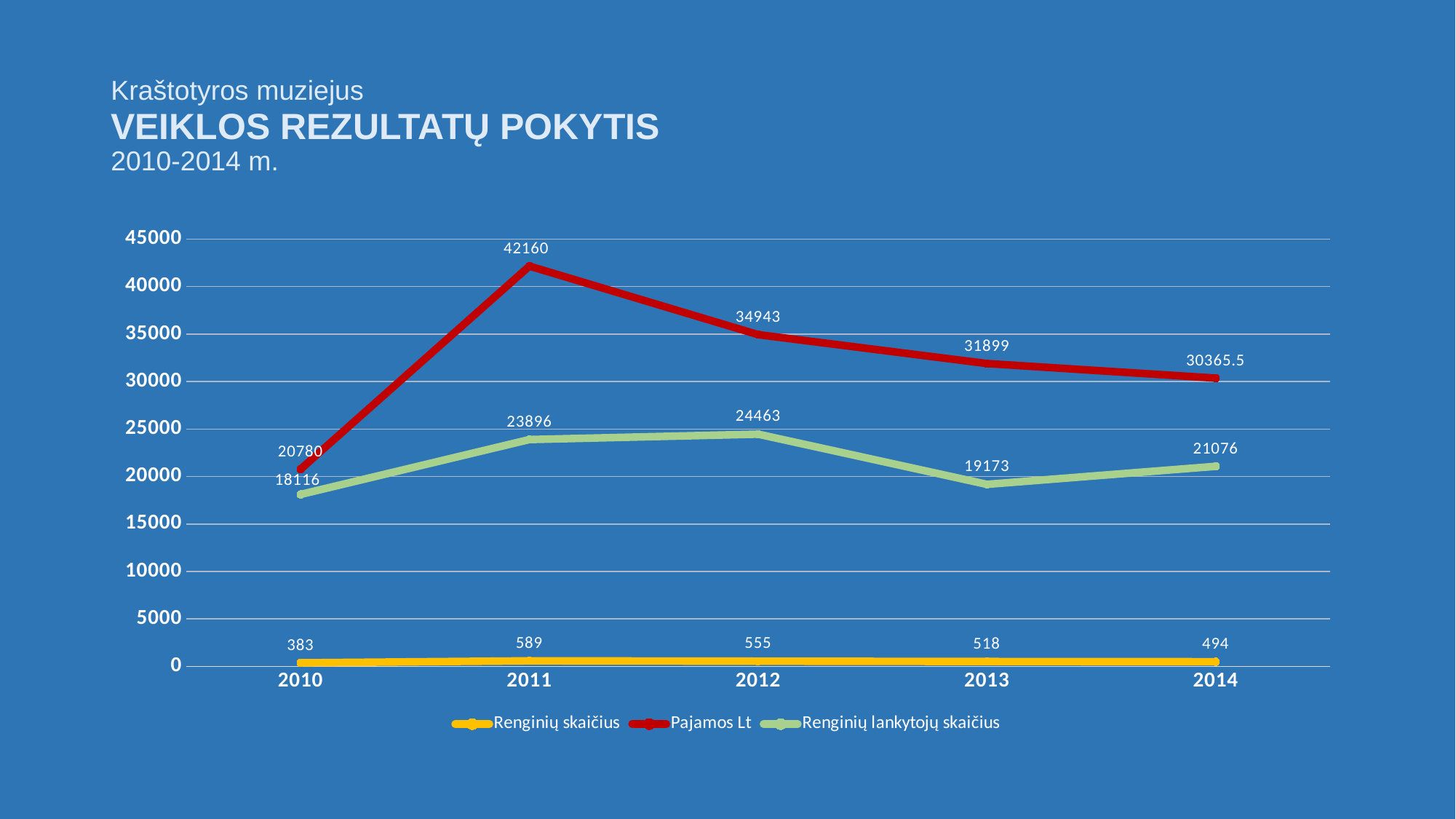
What is the value of Renginių lankytojų skaičius in 2013? 19173 What is the difference between Pajamos Lt in 2011 and in 2012? 7217 Which is larger: Renginių lankytojų skaičius in 2011 or in 2012? 2012 In which year is Renginių lankytojų skaičius lowest? 2010 What is the value of Pajamos Lt in 2014? 30365.5 In which year is Pajamos Lt highest? 2011 What kind of chart is shown on the slide? Line chart What is the value of Pajamos Lt in 2011? 42160 How many series does the legend list? 3 How many years are shown on the x axis? 5 Does Pajamos Lt rise or fall from 2011 to 2014? Fall What is the value of Renginių skaičius in 2010? 383